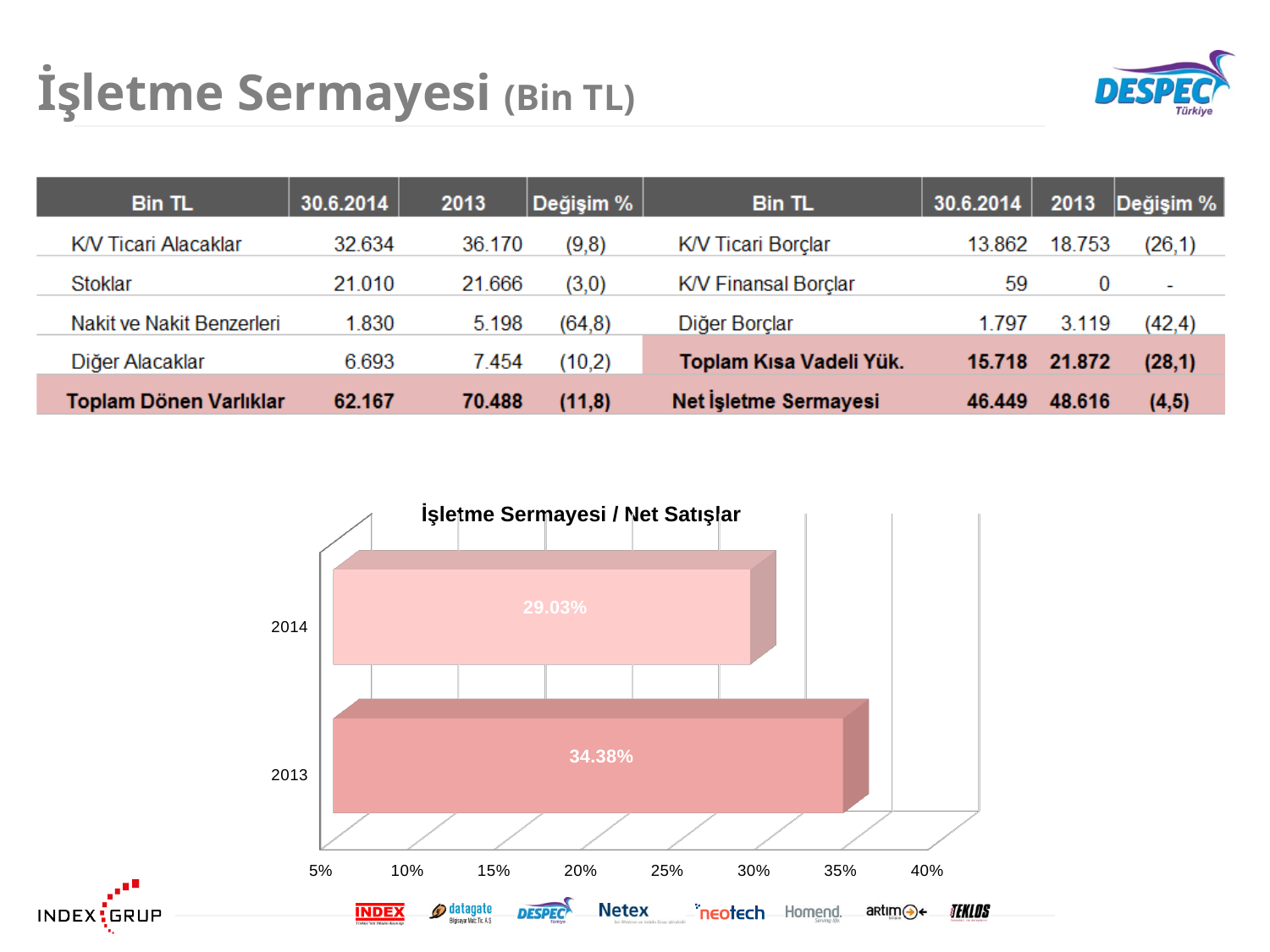
Did the İşletme Sermayesi / Net Satışlar ratio rise or fall from 2013 to 2014? fall Which year has the higher value in the İşletme Sermayesi / Net Satışlar chart? 2013 What is the difference between the 2013 and 2014 values in the İşletme Sermayesi / Net Satışlar chart? 5.35% What is the value for 2013 in the İşletme Sermayesi / Net Satışlar chart? 34.38% What is the value for 2014 in the İşletme Sermayesi / Net Satışlar chart? 29.03% What type of chart is shown on the slide? bar chart Which year has the lower value in the İşletme Sermayesi / Net Satışlar chart? 2014 What is the title of the chart on the slide? İşletme Sermayesi / Net Satışlar Is the value for 2013 in the İşletme Sermayesi / Net Satışlar chart greater or less than 30%? greater How many bars are shown in the İşletme Sermayesi / Net Satışlar chart? 2 Is the value for 2014 in the İşletme Sermayesi / Net Satışlar chart larger or smaller than the value for 2013? smaller Is the value for 2014 in the İşletme Sermayesi / Net Satışlar chart greater or less than 30%? less